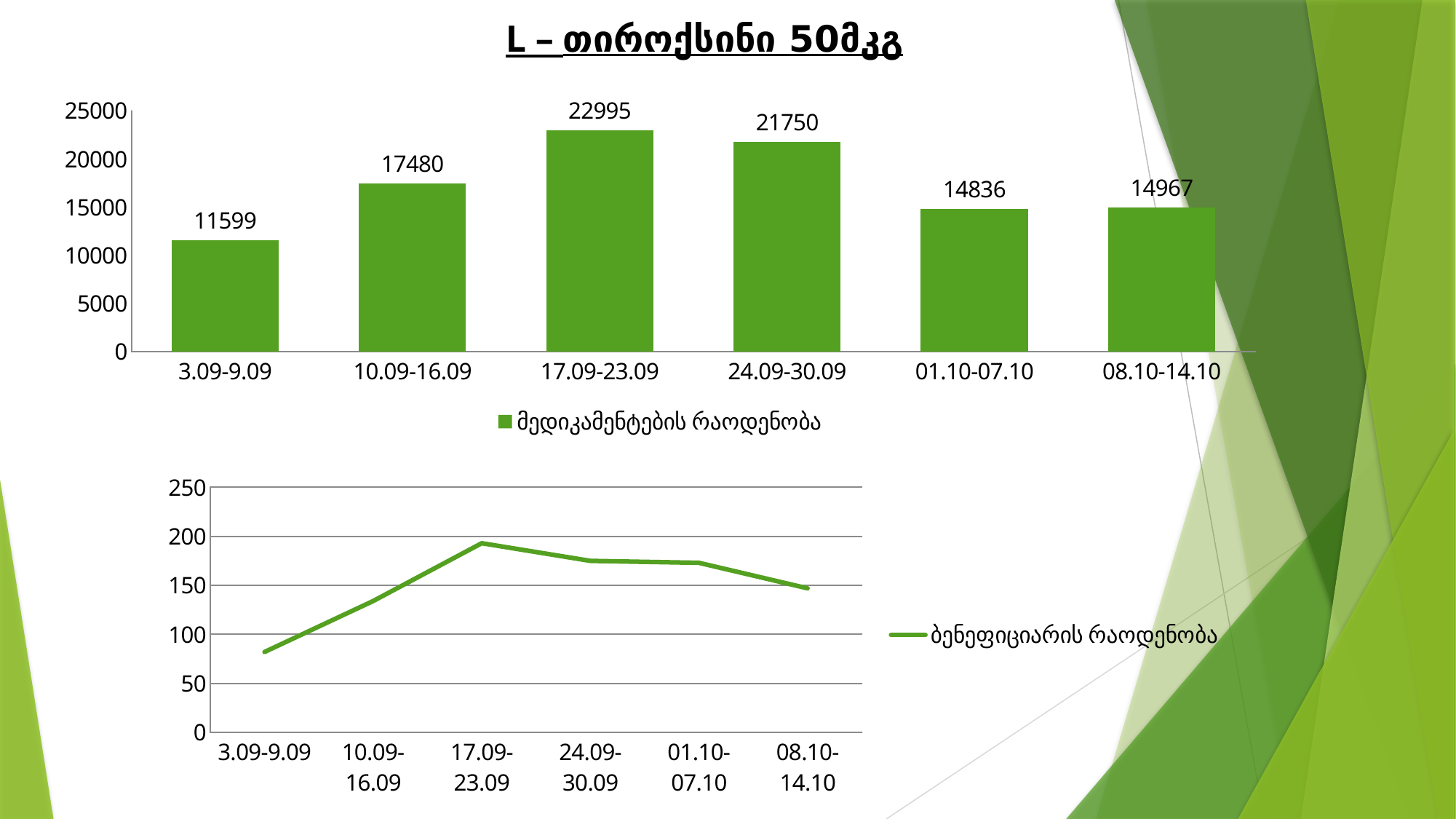
In the top bar chart, what is the value for 17.09-23.09? 22995 What type of chart is the top chart on the slide? bar chart What type of chart is the bottom chart on the slide? line chart In the top bar chart, which period has the lowest value? 3.09-9.09 In the bottom line chart, which period has the highest value? 17.09-23.09 In the top bar chart, what is the difference between the values for 17.09-23.09 and 24.09-30.09? 1245 In the top bar chart, what is the value for 3.09-9.09? 11599 In the bottom line chart, is the value for 3.09-9.09 greater or less than 100? less In the top bar chart, which is larger: the value for 01.10-07.10 or for 08.10-14.10? 08.10-14.10 In the top bar chart, which period has the highest value? 17.09-23.09 What is the legend entry of the bottom line chart? ბენეფიციარის რაოდენობა How many periods are shown on the x axis of the top bar chart? 6